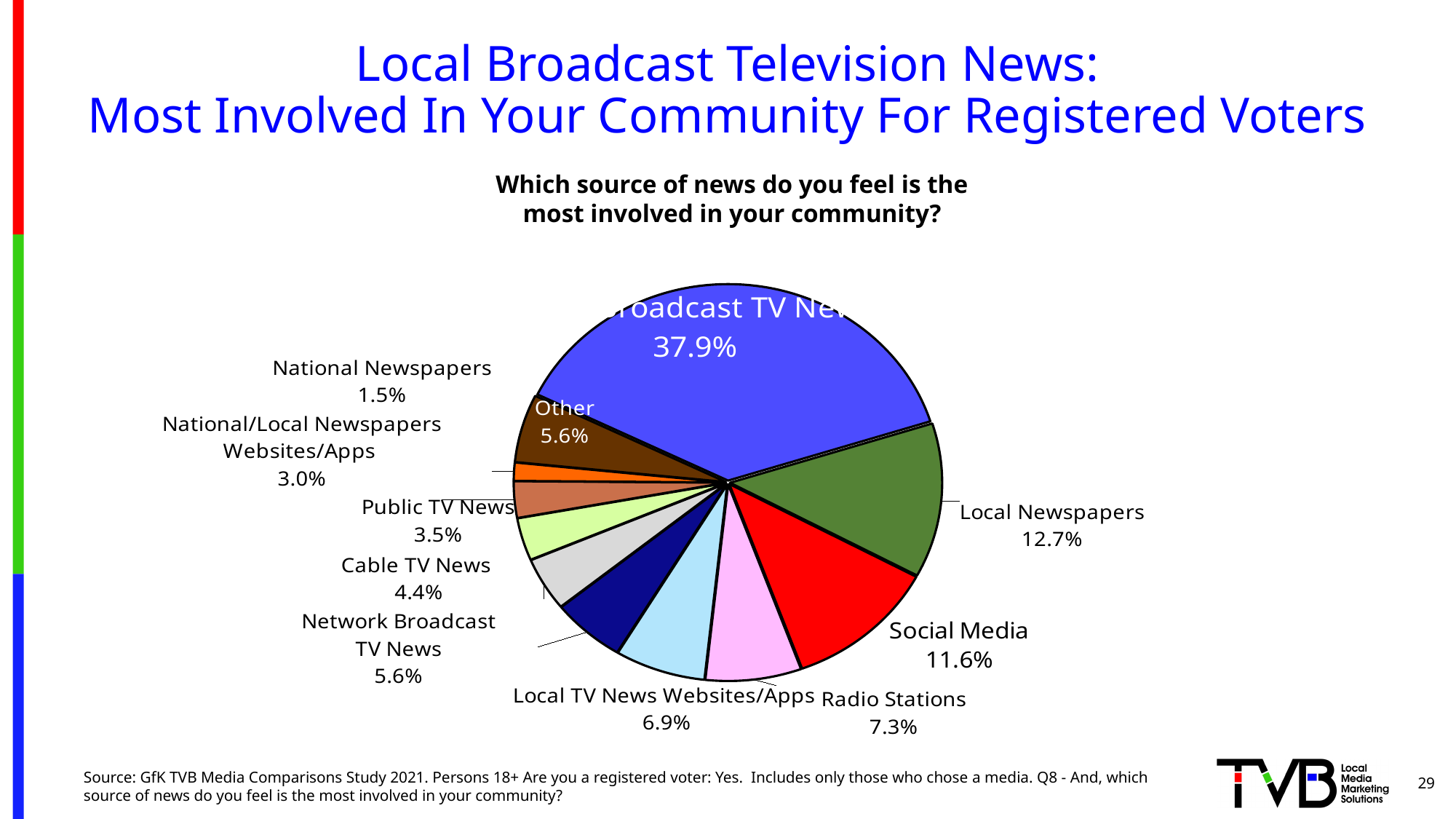
What percentage of registered voters chose Local Newspapers as the news source most involved in their community? 12.7% What is the largest percentage shown on the pie chart? 37.9% What type of chart is shown on the slide? pie chart What value is shown for Local TV News Websites/Apps? 6.9% What percentage is shown for Radio Stations? 7.3% Which news source has the smallest slice of the pie? National Newspapers What share of the pie is Social Media? 11.6% Which has a larger share, Public TV News or Cable TV News? Cable TV News What percentage is shown for Cable TV News? 4.4% What is the difference in percentage points between Local Newspapers and Social Media? 1.1 What question is the pie chart answering, as stated in the chart heading? Which source of news do you feel is the most involved in your community? How many slices does the pie chart have? 11